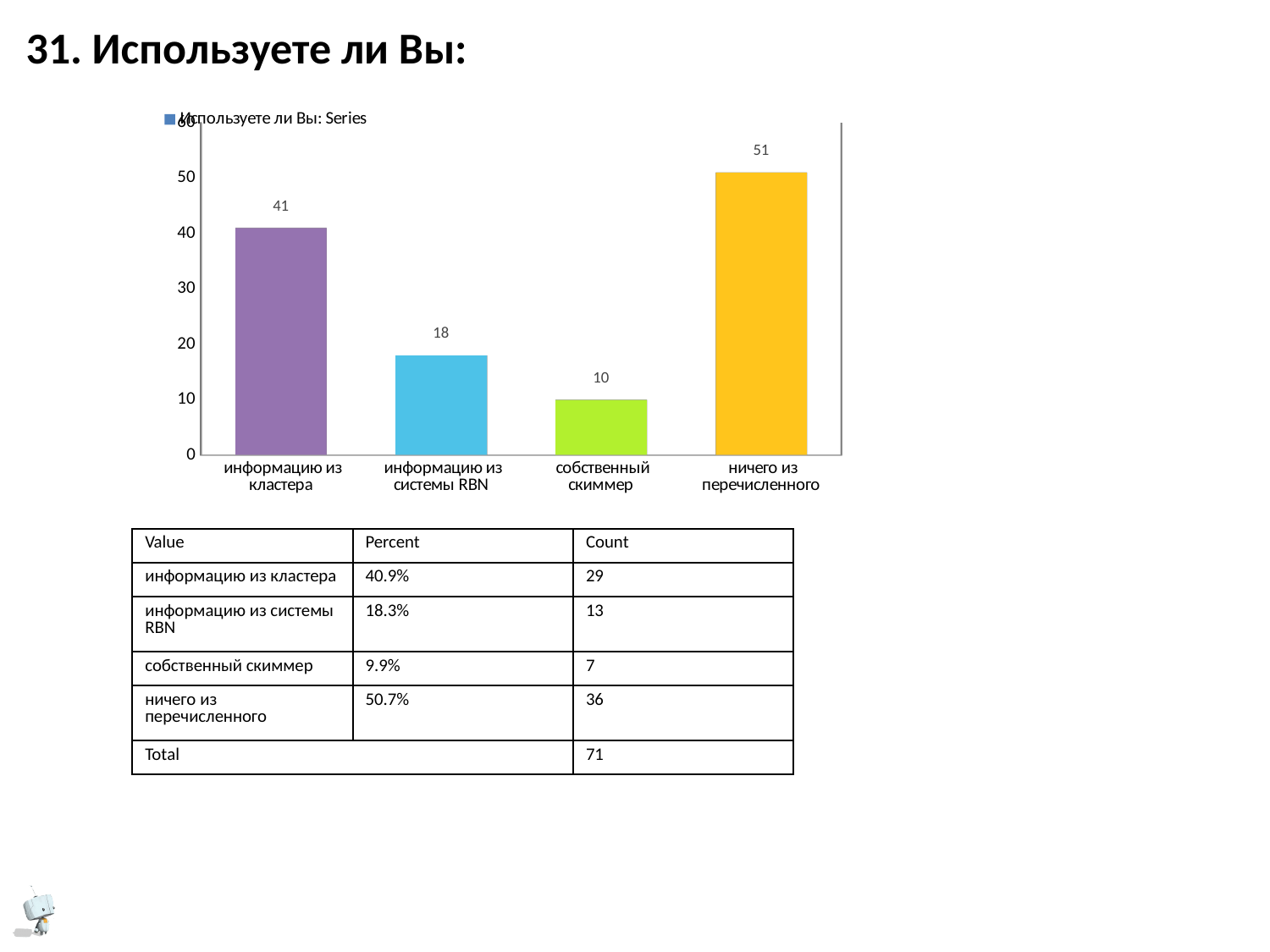
What value does the chart show for "информацию из системы RBN"? 18 What value does the chart show for "информацию из кластера"? 41 What is the legend entry shown above the chart? Используете ли Вы: Series What kind of chart is shown on the slide? bar chart What is the difference between the values for "ничего из перечисленного" and "информацию из кластера"? 10 Which is larger: the value for "информацию из системы RBN" or the value for "собственный скиммер"? информацию из системы RBN Is the value for "информацию из кластера" greater or less than 30? greater Which category has the highest bar in the chart? ничего из перечисленного How many categories are shown on the x axis of the chart? 4 Which category has the lowest bar in the chart? собственный скиммер What value does the chart show for "ничего из перечисленного"? 51 What value does the chart show for "собственный скиммер"? 10